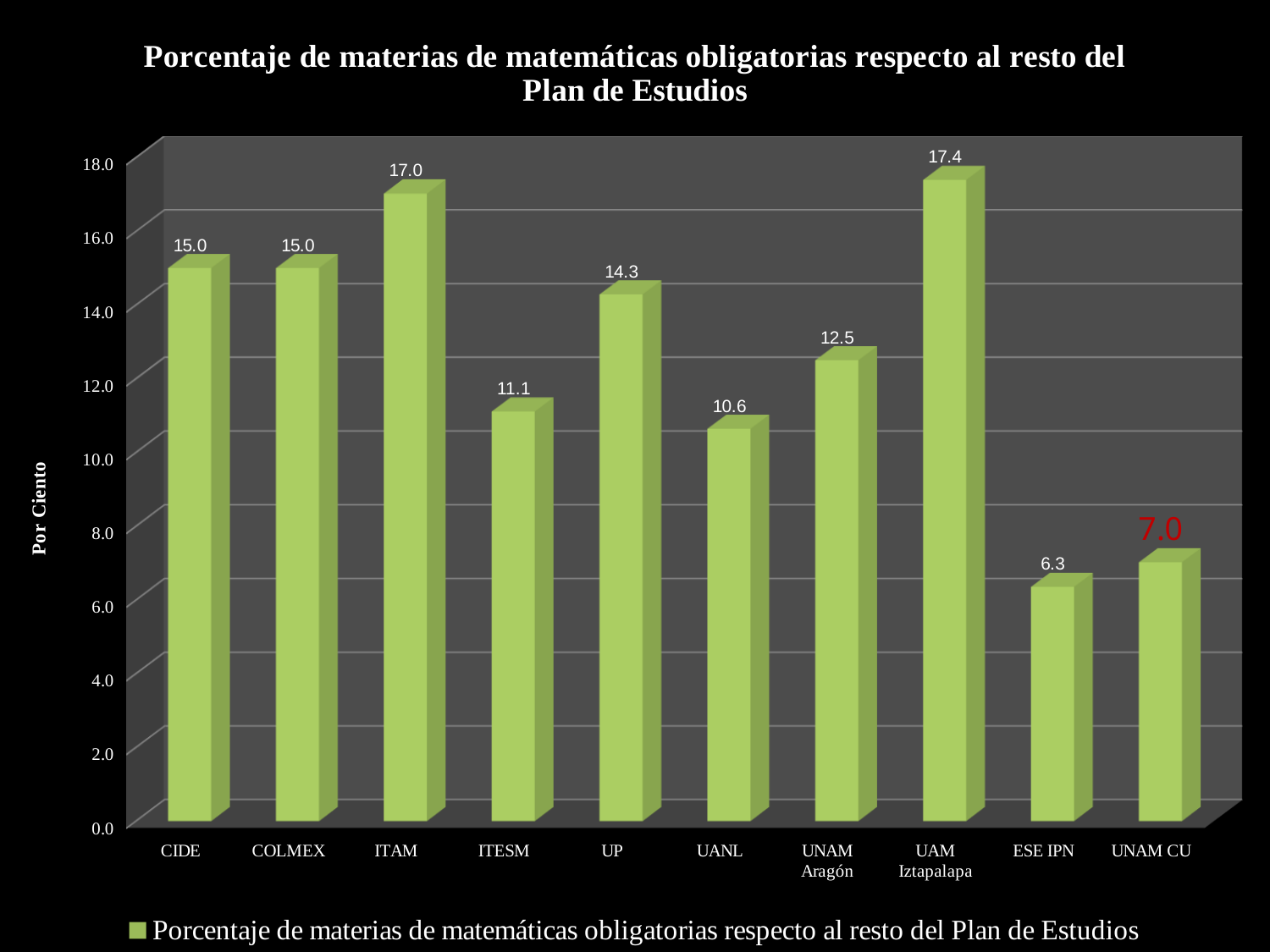
What is the label of the vertical axis? Por Ciento What is the value for UNAM Aragón? 12.5 How many series does the legend list? 1 How many categories are shown on the x axis? 10 Which category has the highest value? UAM Iztapalapa What is the value for UNAM CU? 7.0 Which is larger, the value for UP or the value for UANL? UP What is the value for ITAM? 17.0 Which category has the lowest value? ESE IPN Is the value for ITESM greater or less than 12.0? less What is the difference between the values for UAM Iztapalapa and ESE IPN? 11.1 What kind of chart is shown on the slide? bar chart